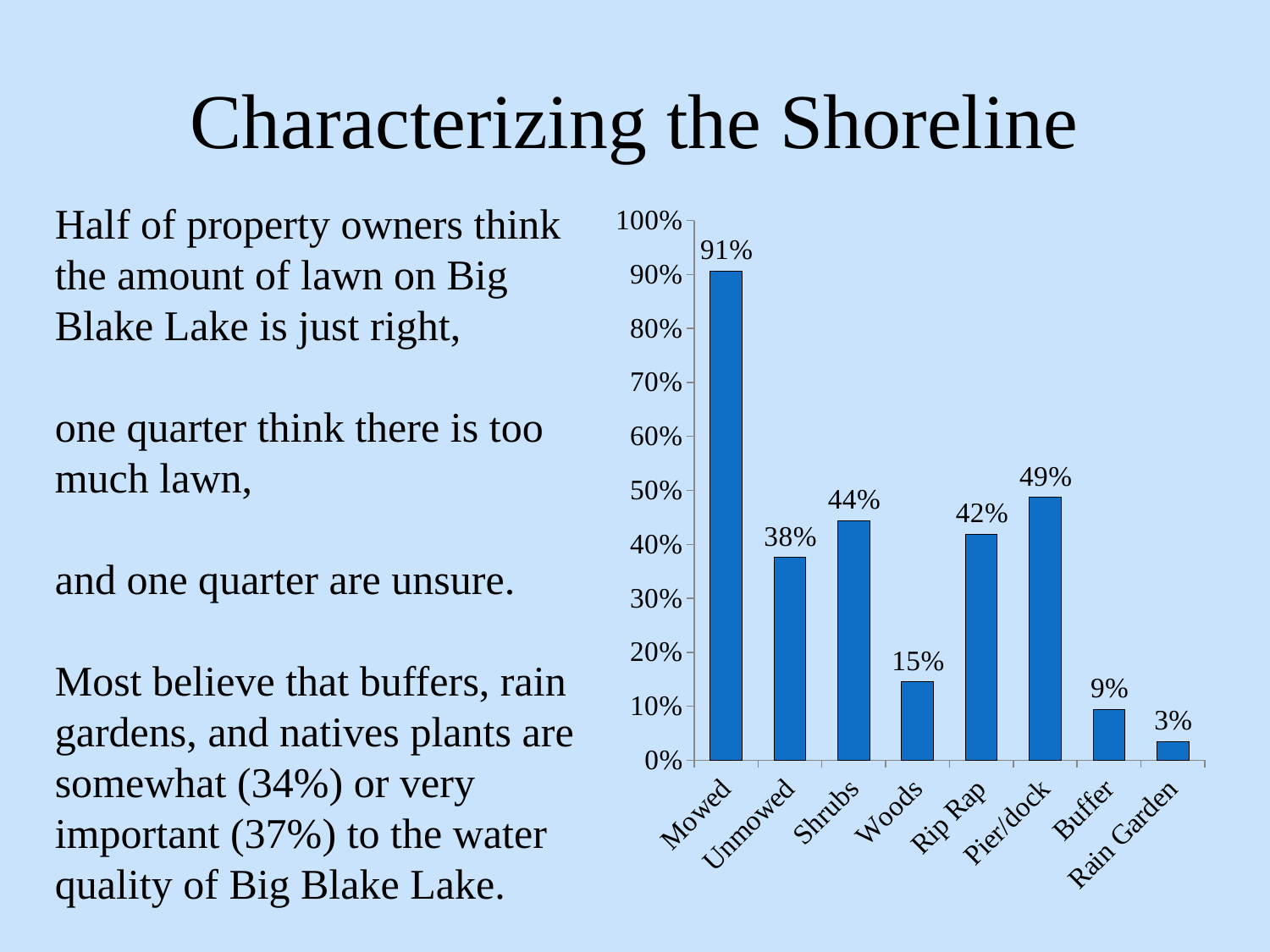
What is the difference between the values for Mowed and Unmowed? 53% How many categories are shown on the x axis? 8 Which category has the lowest value? Rain Garden What is the value for Rain Garden? 3% Is the value for Woods greater or less than 20%? less What is the title of the slide containing the chart? Characterizing the Shoreline Which is larger, the value for Shrubs or the value for Unmowed? Shrubs What is the value for Pier/dock? 49% What kind of chart is shown on the slide? bar chart What is the difference between the values for Pier/dock and Rip Rap? 7% Which category has the highest value? Mowed What is the value for Mowed? 91%